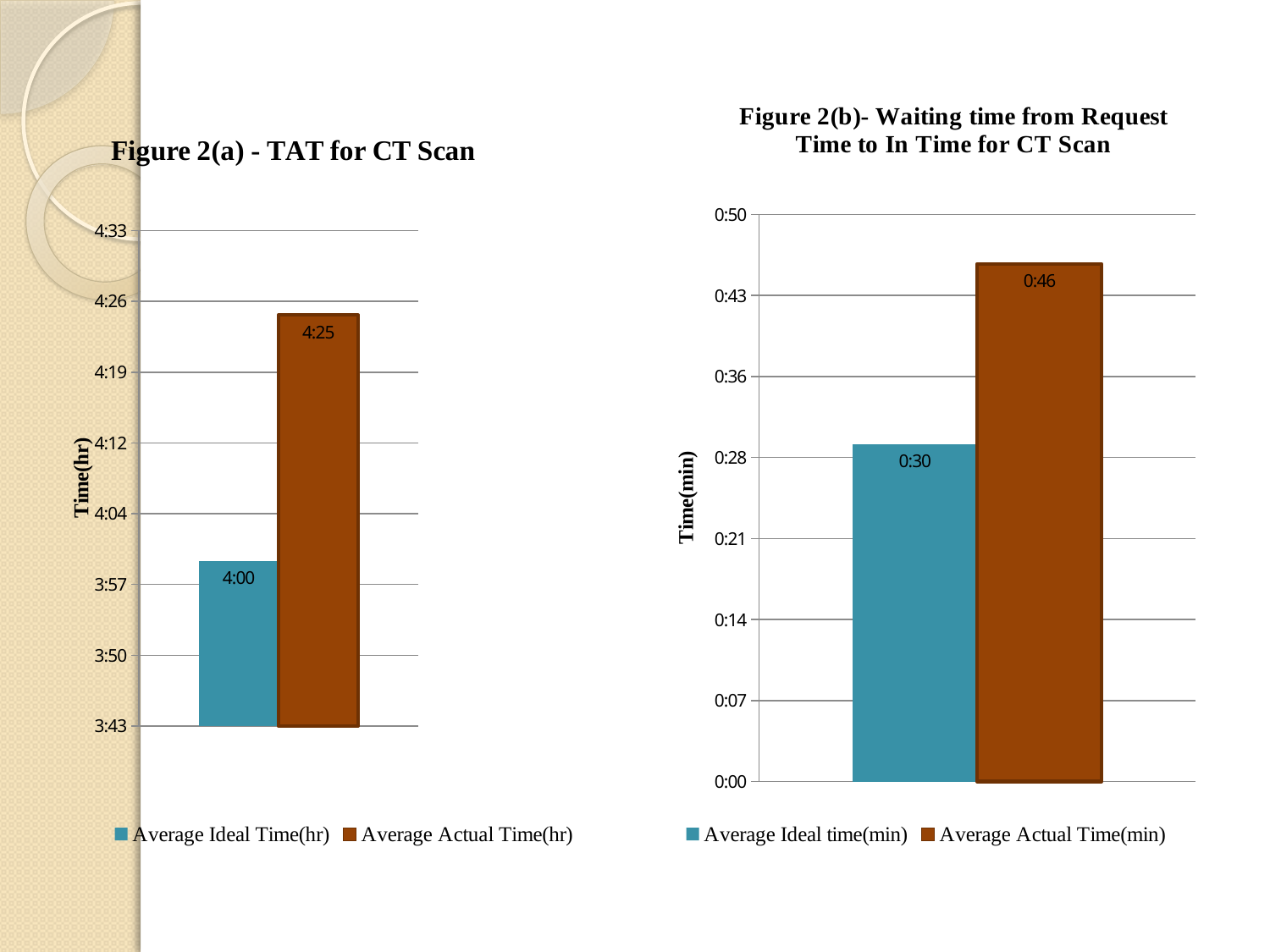
In the Figure 2(a) - TAT for CT Scan chart, what is the value for Average Actual Time(hr)? 4:25 In the Figure 2(a) - TAT for CT Scan chart, which series has the higher value? Average Actual Time(hr) In the Figure 2(b) chart, which series has the lower value? Average Ideal time(min) What is the y-axis label of the Figure 2(b) chart? Time(min) In the Figure 2(b) chart, what is the value for Average Ideal time(min)? 0:30 What kind of chart is Figure 2(b)? Bar chart How many series does the legend of the Figure 2(a) - TAT for CT Scan chart list? 2 In the Figure 2(a) - TAT for CT Scan chart, what is the difference between Average Actual Time(hr) and Average Ideal Time(hr)? 0:25 In the Figure 2(b) chart, is the value for Average Actual Time(min) greater or less than 0:43? greater In the Figure 2(b) chart, what is the value for Average Actual Time(min)? 0:46 In the Figure 2(a) - TAT for CT Scan chart, what is the value for Average Ideal Time(hr)? 4:00 In the Figure 2(b) chart, what is the difference between Average Actual Time(min) and Average Ideal time(min)? 0:16